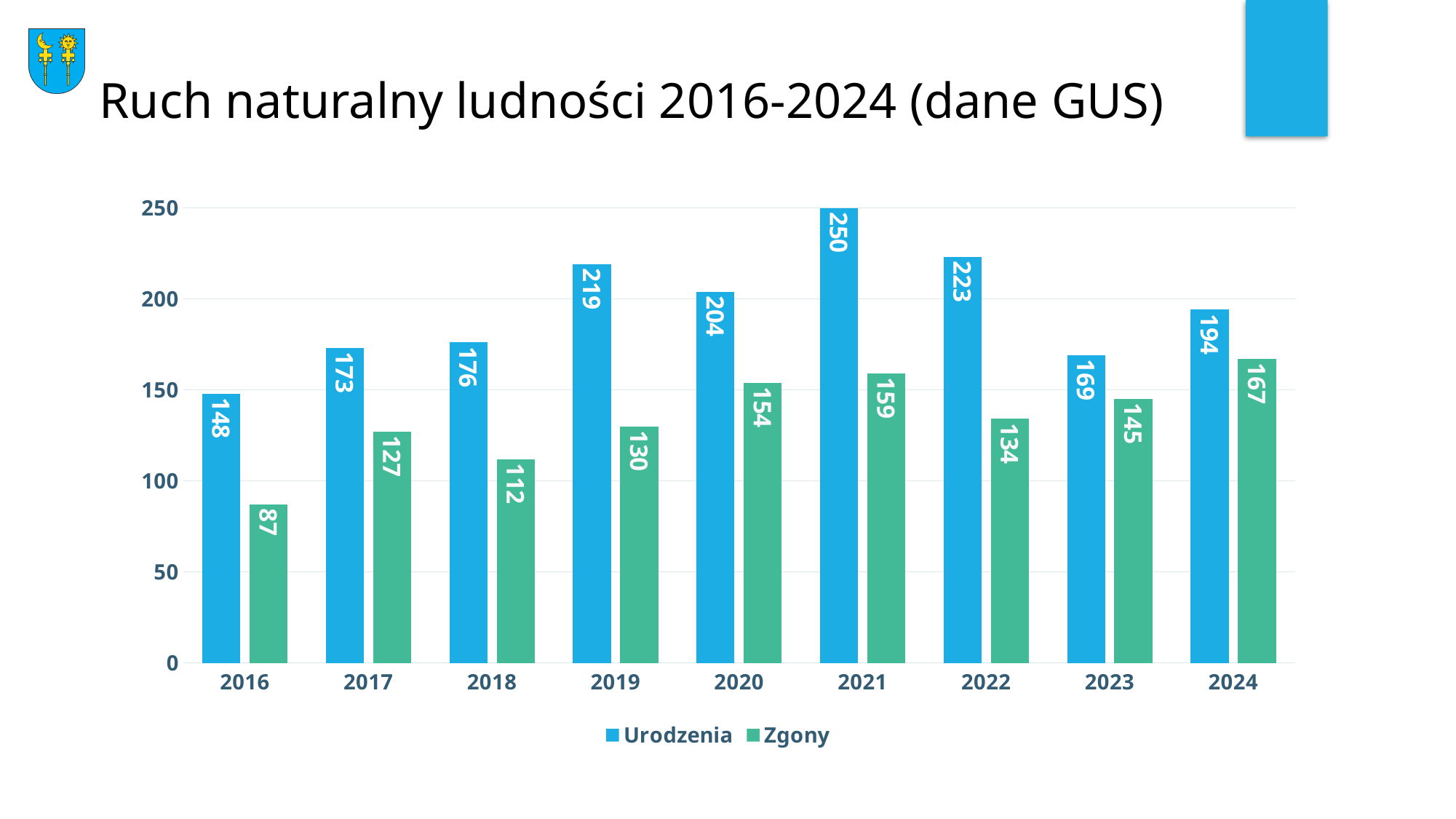
What is the difference between Urodzenia and Zgony in 2021? 91 How many series does the legend list? 2 Which year has the highest Urodzenia value? 2021 How many years are shown on the x axis? 9 What is the value of Urodzenia for 2021? 250 Which year has the lowest Zgony value? 2016 Which is larger in 2023, Urodzenia or Zgony? Urodzenia What is the value of Zgony for 2016? 87 What is the value of Zgony for 2024? 167 Is the Zgony value for 2018 greater or less than 150? less What kind of chart is shown on the slide? bar chart What is the title of the chart on the slide? Ruch naturalny ludności 2016-2024 (dane GUS)